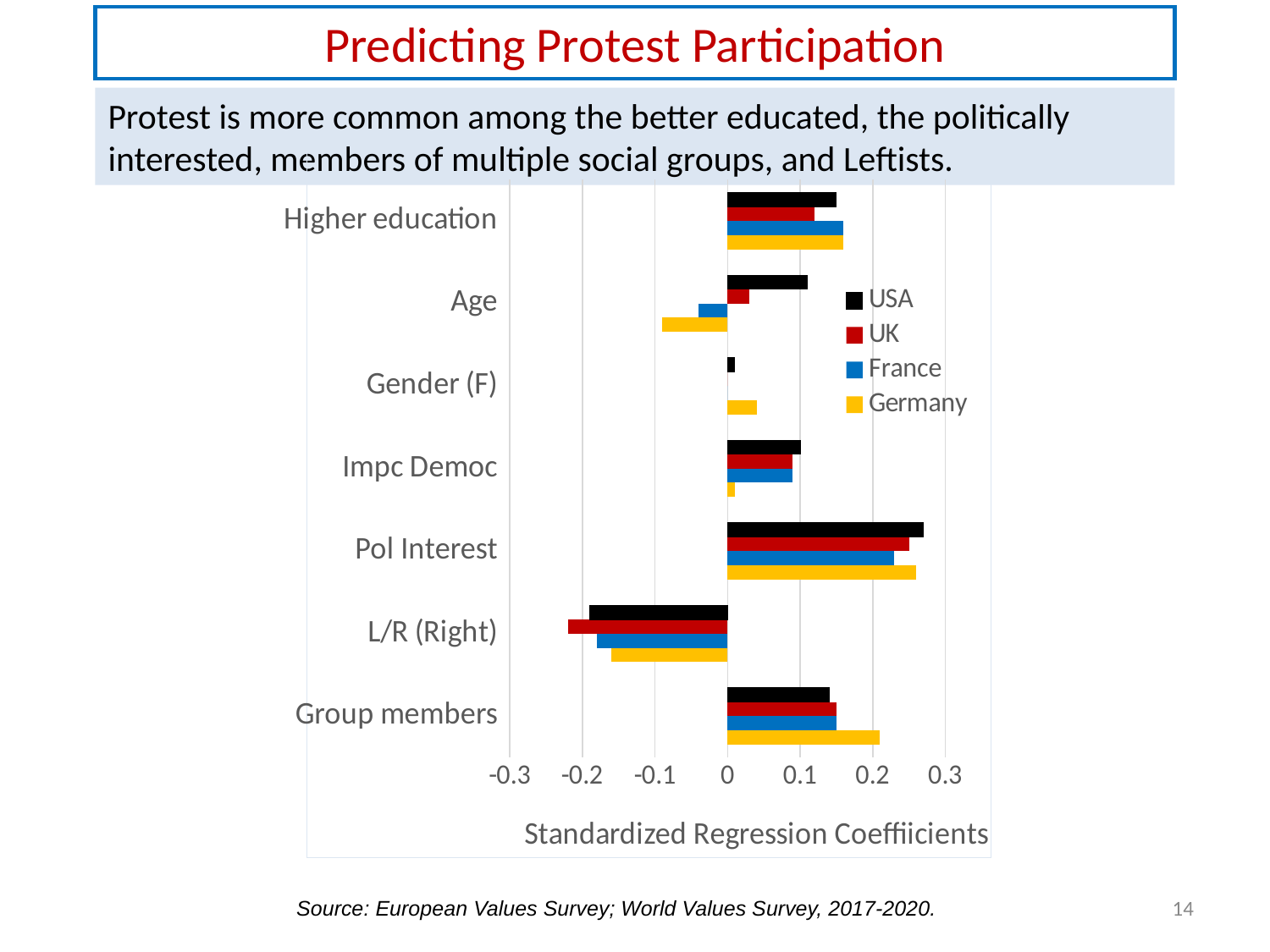
For Age, which is larger: the USA value or the Germany value? USA Is the France value for Higher education greater or less than 0.1? greater What is the title of the horizontal axis of the chart? Standardized Regression Coeffiicients Is the USA value for L/R (Right) greater or less than -0.1? less What kind of chart is shown on the slide? Bar chart Which countries are listed in the chart's legend? USA, UK, France, Germany For which category is the USA coefficient the highest? Pol Interest Is the Germany value for Age greater or less than 0? less Which series has the lowest value for Age? Germany How many categories (predictors) are listed on the vertical axis of the chart? 7 How many series does the chart's legend list? 4